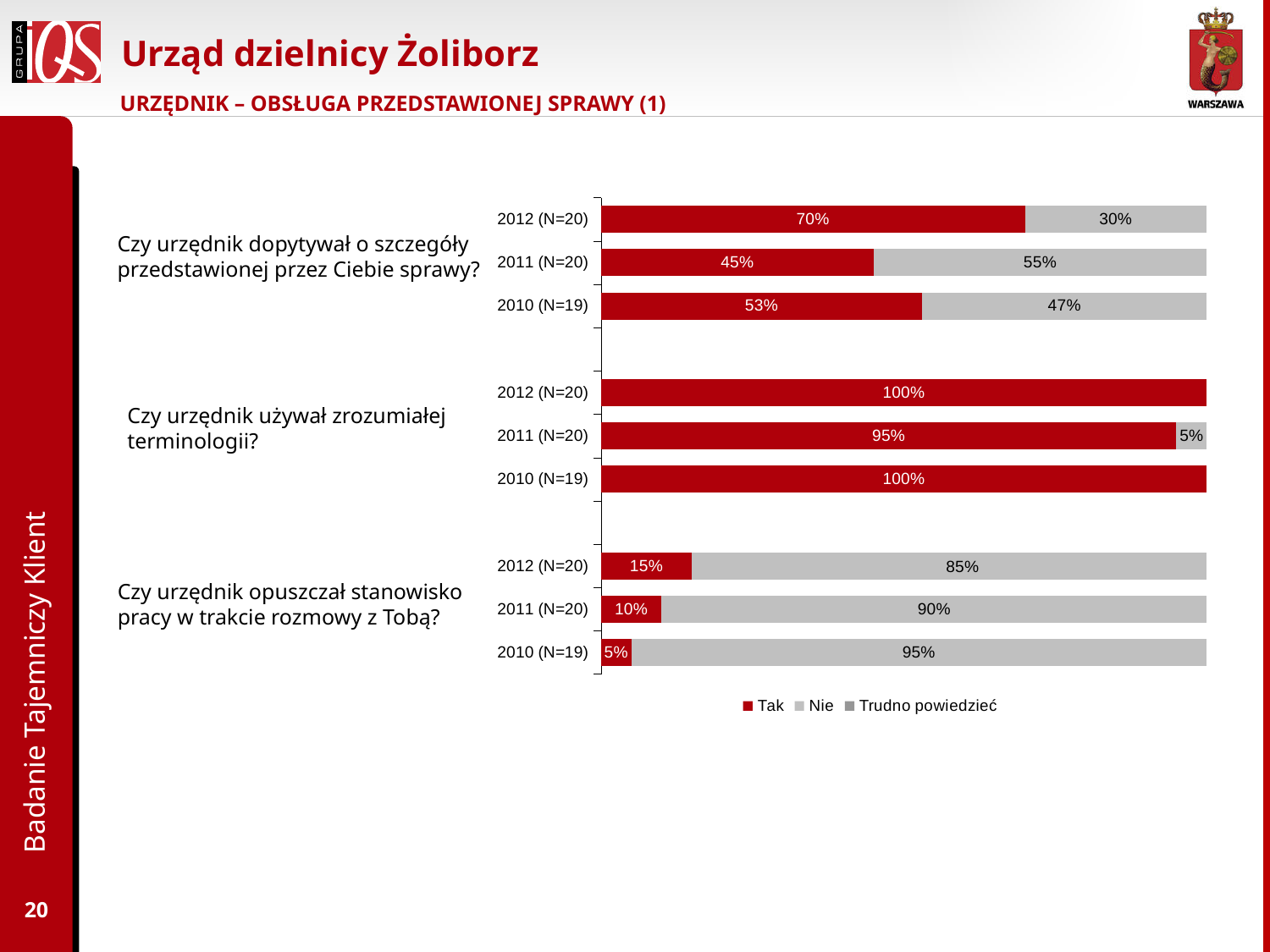
What is the 'Tak' value for 2011 (N=20) for the question 'Czy urzędnik używał zrozumiałej terminologii?'? 95% For the question 'Czy urzędnik opuszczał stanowisko pracy w trakcie rozmowy z Tobą?', is the 'Tak' value larger in 2012 (N=20) or in 2011 (N=20)? 2012 (N=20) What is the difference between the 'Tak' values for 2012 (N=20) and 2011 (N=20) for the question 'Czy urzędnik dopytywał o szczegóły przedstawionej przez Ciebie sprawy?'? 25 percentage points For the question 'Czy urzędnik opuszczał stanowisko pracy w trakcie rozmowy z Tobą?', which year has the lowest 'Tak' value? 2010 (N=19) What is the 'Nie' value for 2010 (N=19) for the question 'Czy urzędnik opuszczał stanowisko pracy w trakcie rozmowy z Tobą?'? 95% For the question 'Czy urzędnik opuszczał stanowisko pracy w trakcie rozmowy z Tobą?', does the 'Tak' value rise or fall from 2010 to 2012? rise How many bars are plotted in the chart in total? 9 For the question 'Czy urzędnik dopytywał o szczegóły przedstawionej przez Ciebie sprawy?', which year has the highest 'Tak' value? 2012 (N=20) How many series does the legend list? 3 What is the 'Nie' value for 2011 (N=20) for the question 'Czy urzędnik dopytywał o szczegóły przedstawionej przez Ciebie sprawy?'? 55% What is the 'Tak' value for 2012 (N=20) for the question 'Czy urzędnik dopytywał o szczegóły przedstawionej przez Ciebie sprawy?'? 70% What type of chart is shown on the slide? stacked bar chart